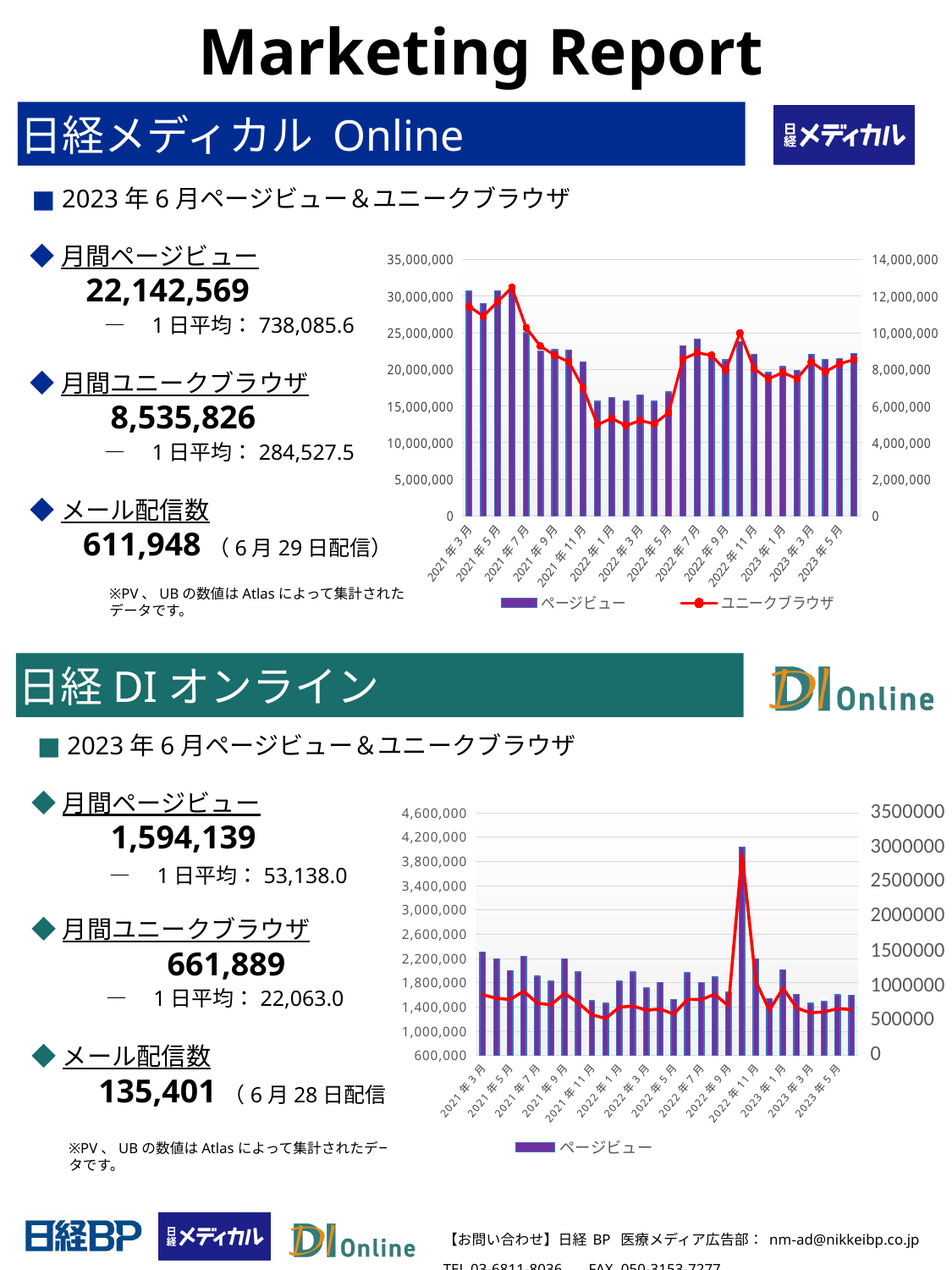
In the 日経メディカル Online chart, which series is drawn as a red line? ユニークブラウザ In the 日経メディカル Online chart, do the ページビュー bars rise or fall from 2021年3月 to 2022年3月? fall In the 日経メディカル Online chart, is the ユニークブラウザ value for 2022年3月 greater or less than 6,000,000 on the right axis? less In the 日経メディカル Online chart, which is higher: the ページビュー bar for 2021年5月 or the bar for 2022年5月? 2021年5月 In the 日経DI オンライン chart, which month has the highest ページビュー bar? 2022年10月 How many series does the legend of the 日経DI オンライン chart list? 1 In the 日経DI オンライン chart, is the ページビュー bar for 2022年11月 greater or less than 3,800,000? less What kind of chart is shown for 日経メディカル Online? A bar chart combined with a line chart How many series does the legend of the 日経メディカル Online chart list? 2 In the 日経メディカル Online chart, is the ページビュー bar for 2022年1月 greater or less than 20,000,000? less